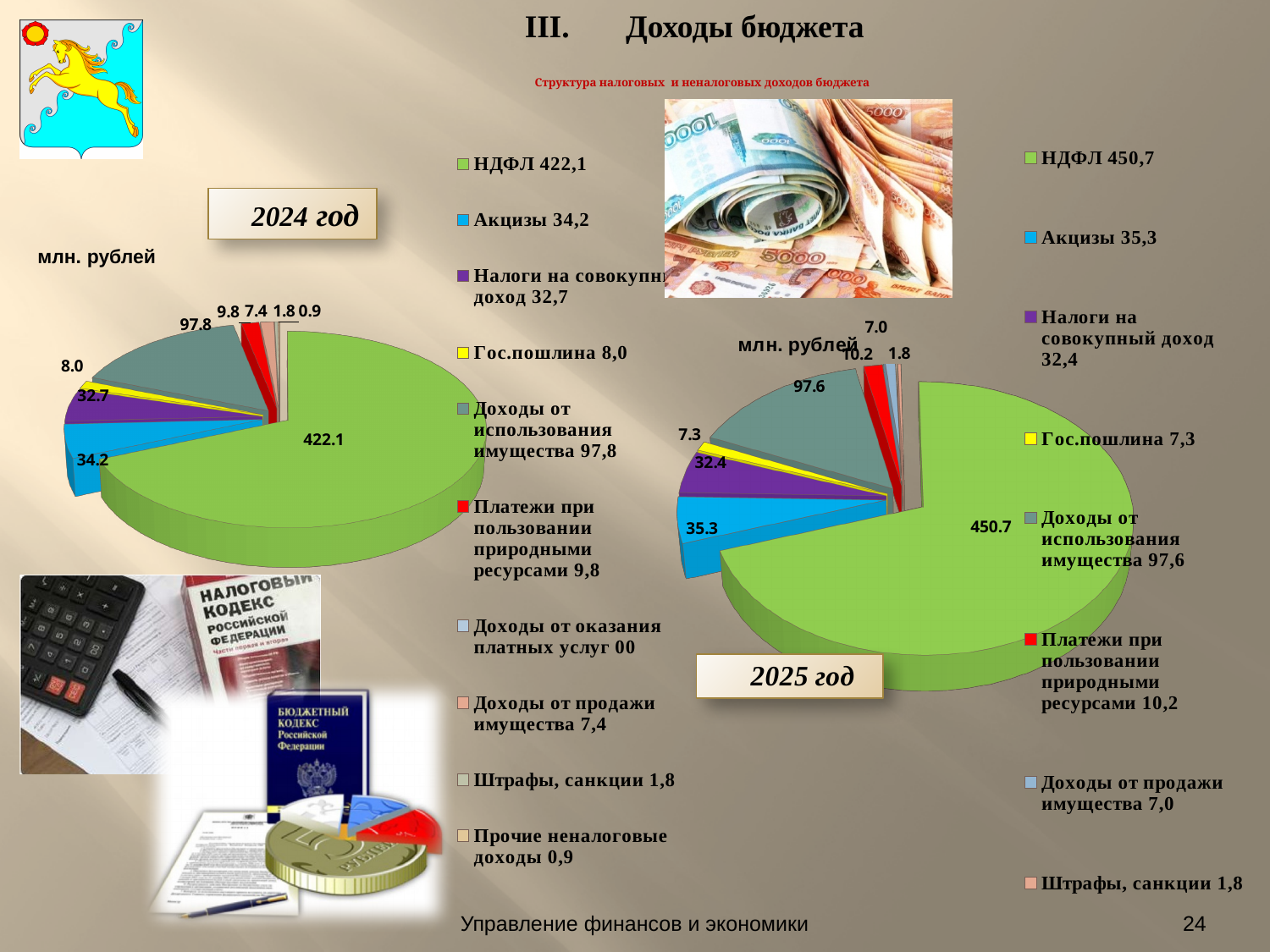
Which is larger: Гос.пошлина in the 2024 chart or Гос.пошлина in the 2025 chart? 2024 What type of chart is used for the 2024 data? Pie chart In the 2024 pie chart, which category has the smallest non-zero value? Прочие неналоговые доходы In the 2025 pie chart, what is the value for Акцизы? 35.3 In the 2024 pie chart, what is the difference between Акцизы and Налоги на совокупный доход? 1.5 What unit is shown next to both charts? млн. рублей In the 2025 pie chart, which category has the largest value? НДФЛ In the 2024 pie chart, what is the value for Доходы от использования имущества? 97.8 What is the difference between НДФЛ in the 2025 chart and НДФЛ in the 2024 chart? 28.6 How many categories does the legend of the 2025 pie chart list? 8 In the 2024 pie chart, what is the value for НДФЛ? 422.1 In the 2025 pie chart, what is the value for Платежи при пользовании природными ресурсами? 10.2